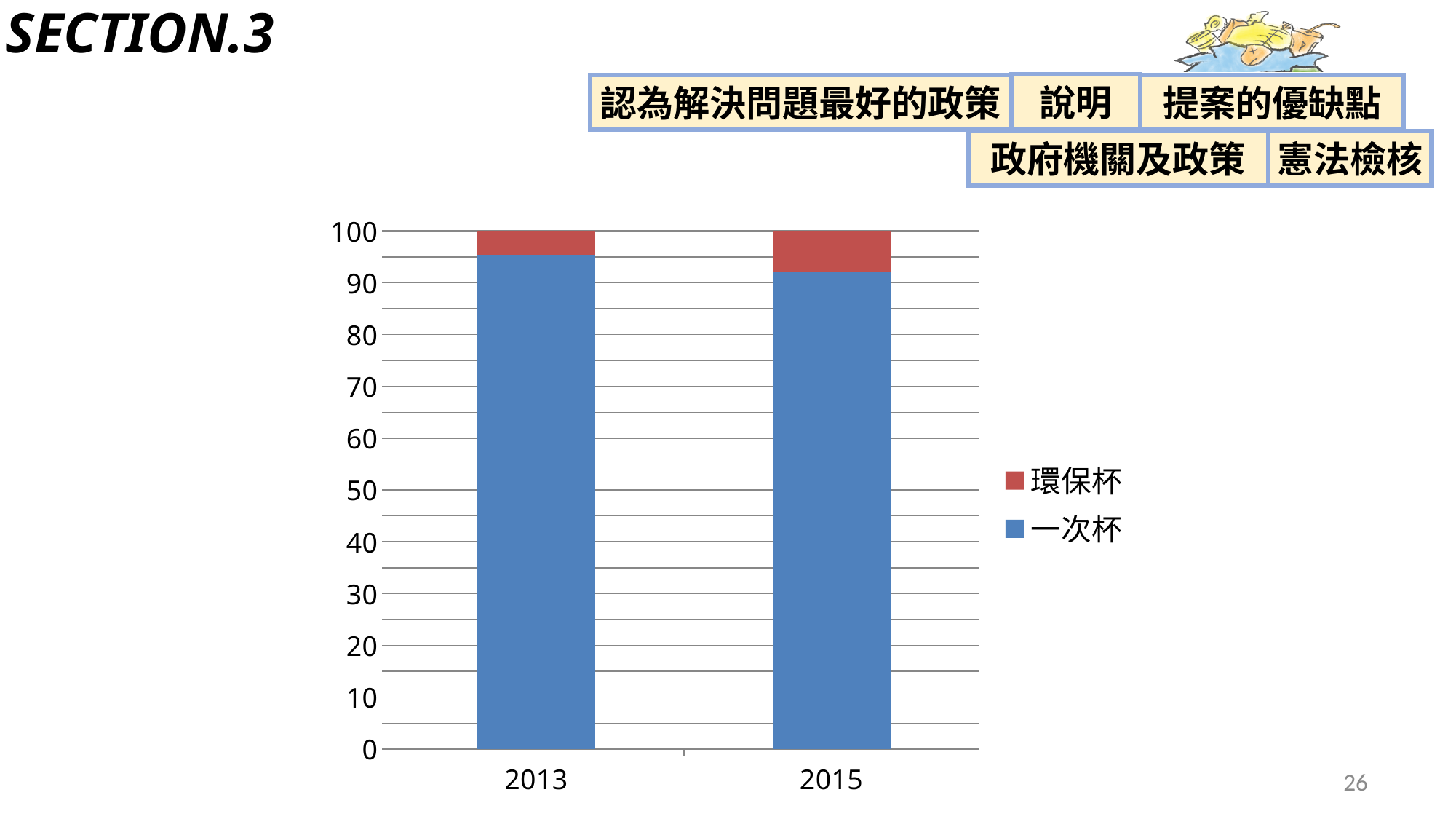
What kind of chart is shown on the slide? stacked bar chart How many categories are shown on the x axis of the chart? 2 Does the value for 一次杯 rise or fall from 2013 to 2015? fall How many series does the chart's legend list? 2 Is the value for 環保杯 in 2015 greater or less than 20? less What are the two categories on the x axis of the chart? 2013 and 2015 What is the total height of the stacked bar for 2013? 100 Is the value for 一次杯 in 2015 greater or less than 80? greater Which year has the larger value for 環保杯, 2013 or 2015? 2015 Which series is shown in red in the chart's legend? 環保杯 Is the value for 一次杯 in 2013 greater or less than 90? greater